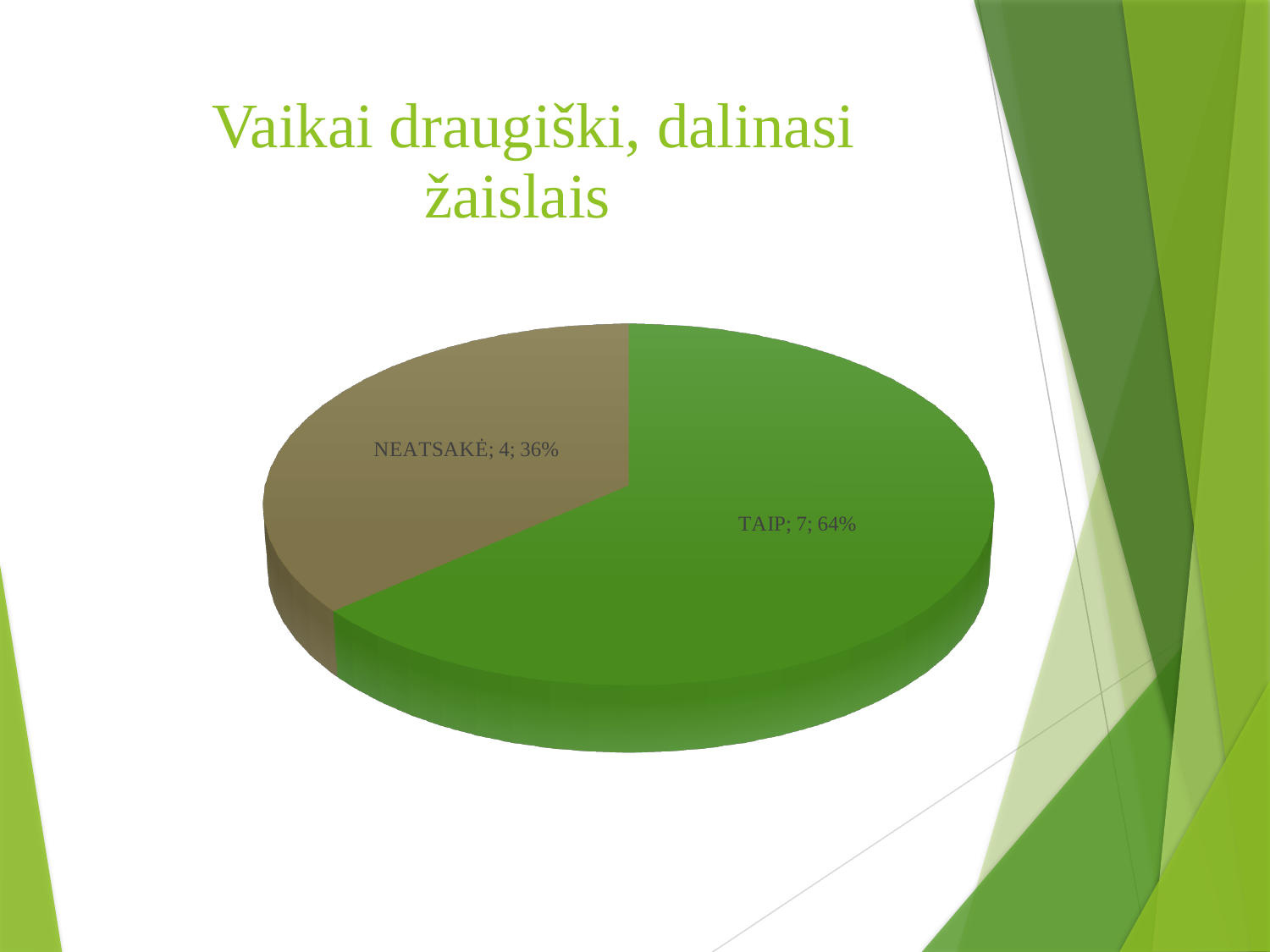
What is the total of the values shown in the pie chart? 11 What kind of chart is shown on the slide? pie chart Which is larger, the value for TAIP or the value for NEATSAKĖ? TAIP What is the title of the slide containing the chart? Vaikai draugiški, dalinasi žaislais What share of the pie does TAIP represent? 64% What is the difference between the values for TAIP and NEATSAKĖ? 3 What is the value for TAIP? 7 How many categories are shown in the pie chart? 2 What share of the pie does NEATSAKĖ represent? 36% Which category has the largest slice? TAIP Which category has the smallest slice? NEATSAKĖ What is the value for NEATSAKĖ? 4